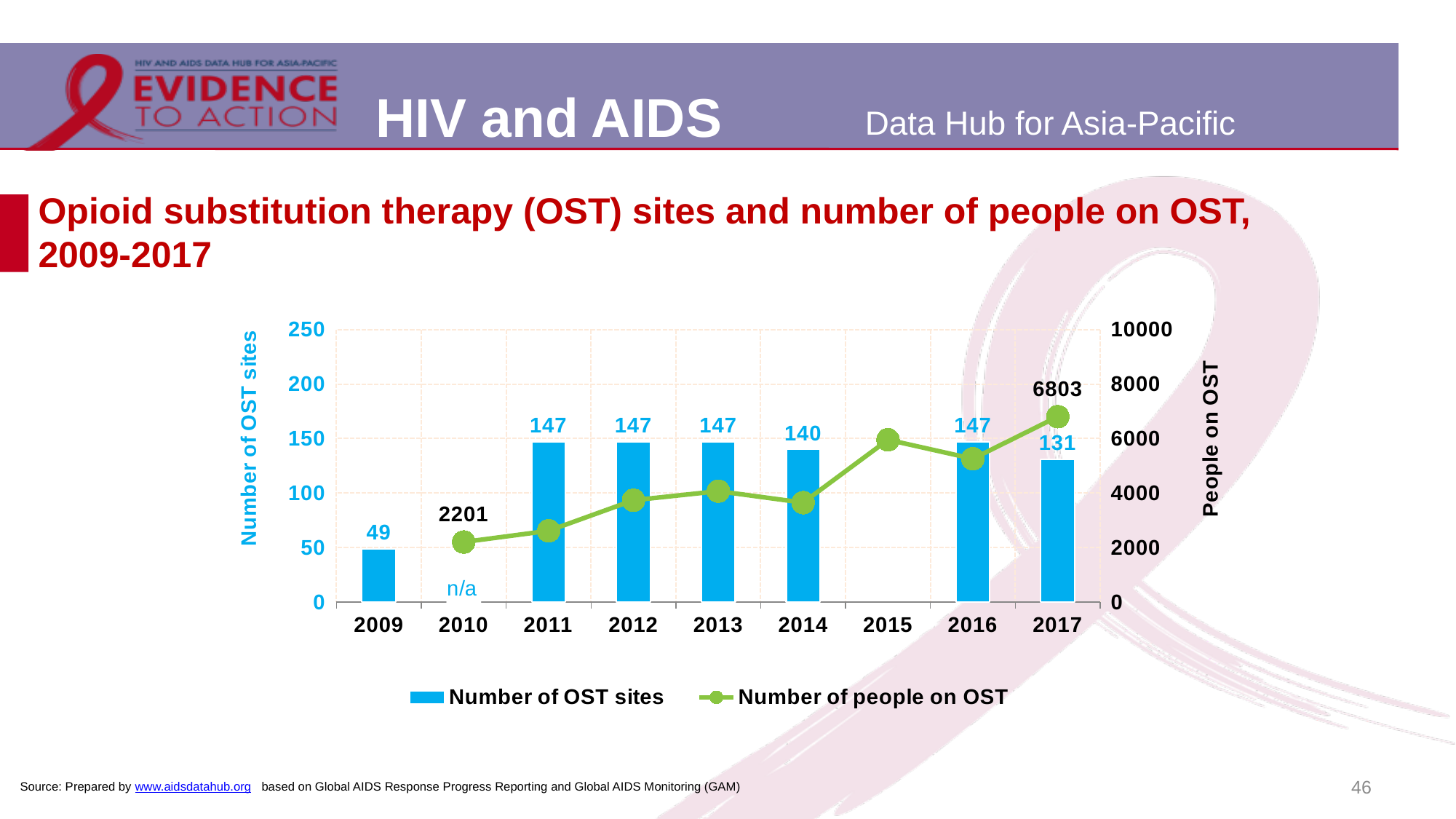
What is the number of OST sites in 2014? 140 What is the difference in the number of people on OST between 2017 and 2010? 4602 What is the number of OST sites in 2017? 131 Is the number of OST sites in 2014 larger or smaller than in 2017? larger What is the number of OST sites in 2009? 49 Is the number of people on OST in 2015 greater or less than 4000? greater What is the number of people on OST in 2010? 2201 Which year has the lowest labelled number of OST sites? 2009 What is the number of people on OST in 2017? 6803 What value is shown for the number of OST sites in 2010? n/a What is the difference in the number of OST sites between 2011 and 2017? 16 How many series does the legend list? 2